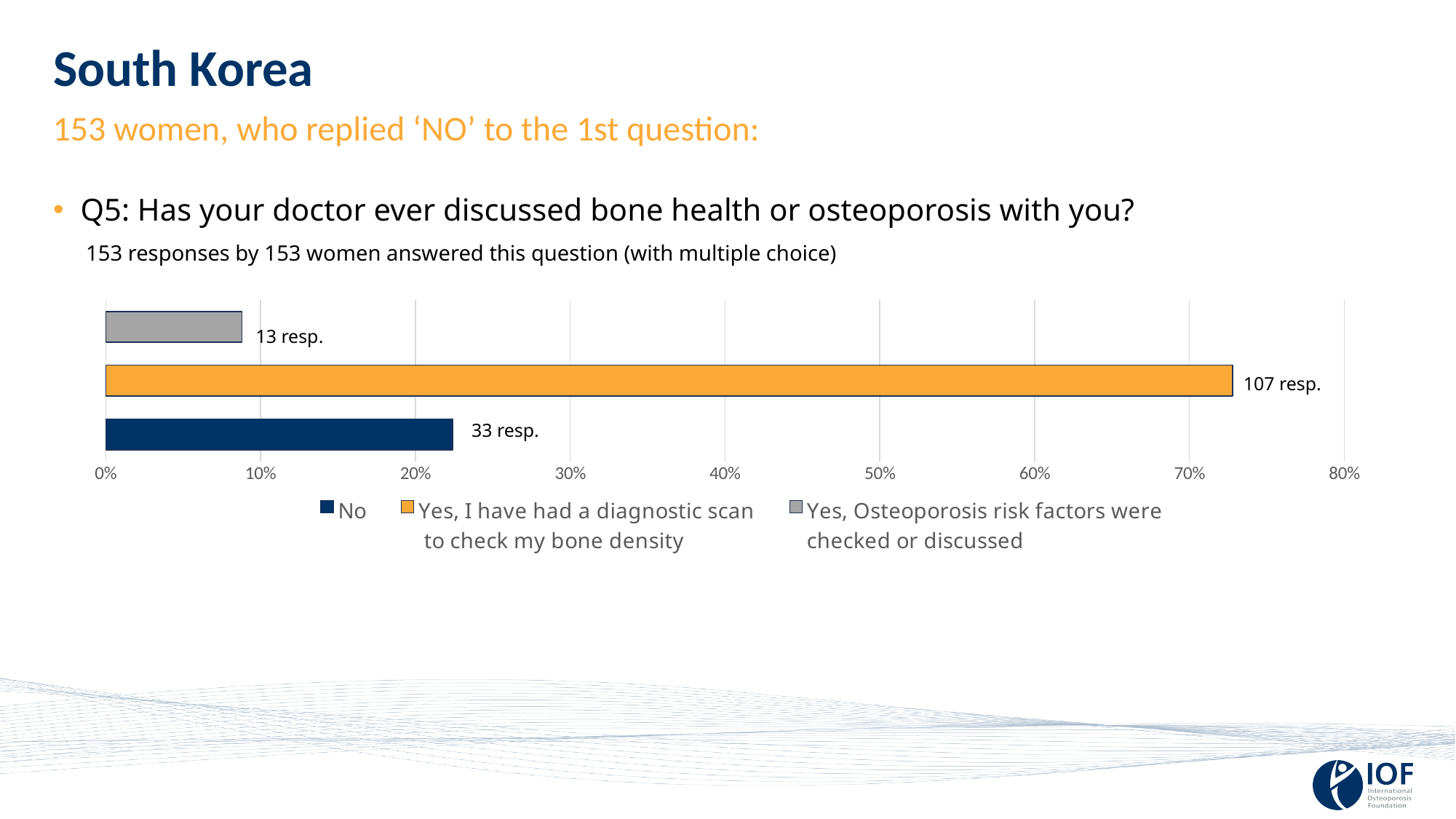
How many series does the legend list? 3 Which response option has the lowest number of responses? Yes, Osteoporosis risk factors were checked or discussed What kind of chart is shown on the slide? bar chart How many responses are shown for 'Yes, Osteoporosis risk factors were checked or discussed'? 13 resp. Is the percentage for 'Yes, I have had a diagnostic scan to check my bone density' greater or less than 70%? greater How many responses are shown for 'Yes, I have had a diagnostic scan to check my bone density'? 107 resp. Which has more responses: 'No' or 'Yes, Osteoporosis risk factors were checked or discussed'? No What colour is the bar for 'No'? dark blue Which response option has the highest number of responses? Yes, I have had a diagnostic scan to check my bone density What is the difference in responses between 'Yes, I have had a diagnostic scan to check my bone density' and 'No'? 74 How many responses are shown for 'No'? 33 resp. Is the percentage for 'No' greater or less than 30%? less